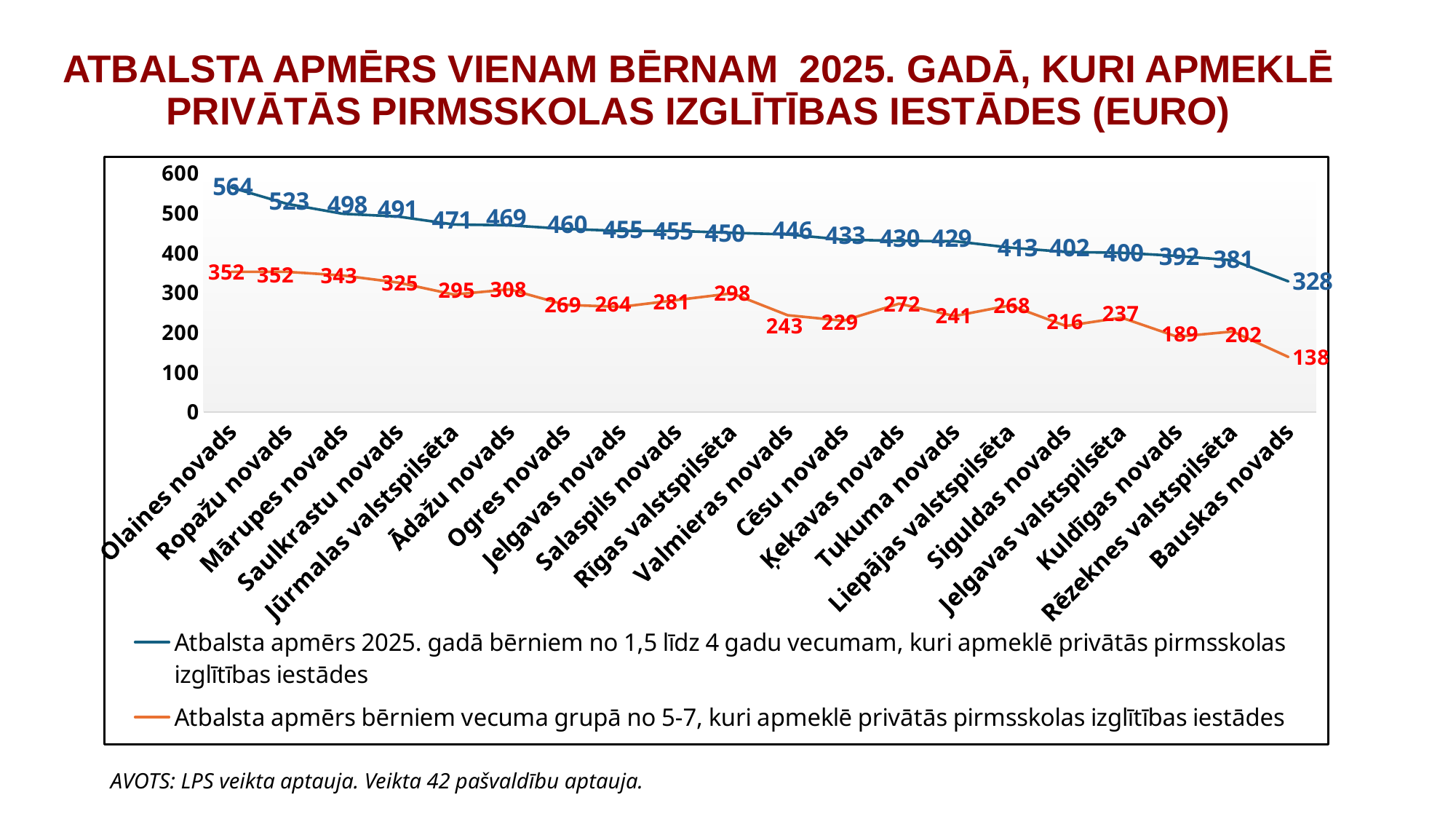
Which is larger: the support amount for children aged 5-7 in Ķekavas novads or in Cēsu novads? Ķekavas novads Which municipality has the highest support amount for children aged 1.5 to 4? Olaines novads How many series does the legend list? 2 Which municipality has the lowest support amount for children aged 5-7? Bauskas novads What is the support amount for children aged 1.5 to 4 in Olaines novads? 564 What is the difference between the two support amounts in Olaines novads? 212 What kind of chart is shown on the slide? line chart What is the support amount for children aged 5-7 in Rīgas valstspilsēta? 298 Is the support amount for children aged 1.5 to 4 in Bauskas novads greater or less than 400? less Does the support amount for children aged 1.5 to 4 generally rise or fall from left to right along the x axis? fall What is the support amount for children aged 5-7 in Bauskas novads? 138 How many municipalities are shown on the x axis? 20